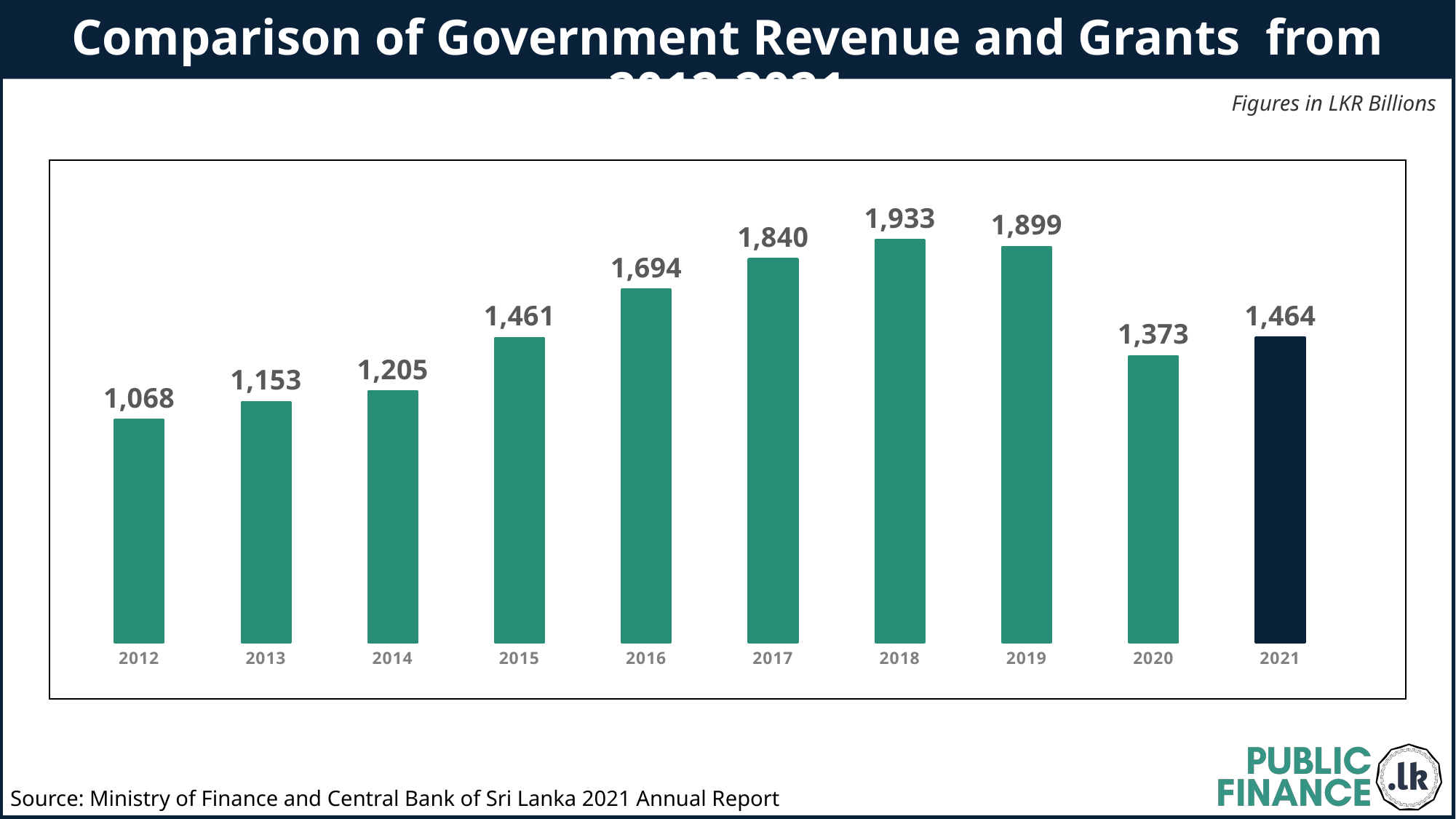
Which is larger, the value for 2016 or the value for 2020? 2016 Do the values rise or fall from 2012 to 2018? rise Which year has the lowest value? 2012 Which year has the highest value? 2018 What is the difference between the values for 2021 and 2020? 91 What kind of chart is this? bar chart What is the difference between the values for 2018 and 2019? 34 What is the value for 2012? 1,068 What is the value for 2018? 1,933 What is the value for 2021? 1,464 How many years are shown on the chart? 10 Which bar is coloured differently from the others? 2021